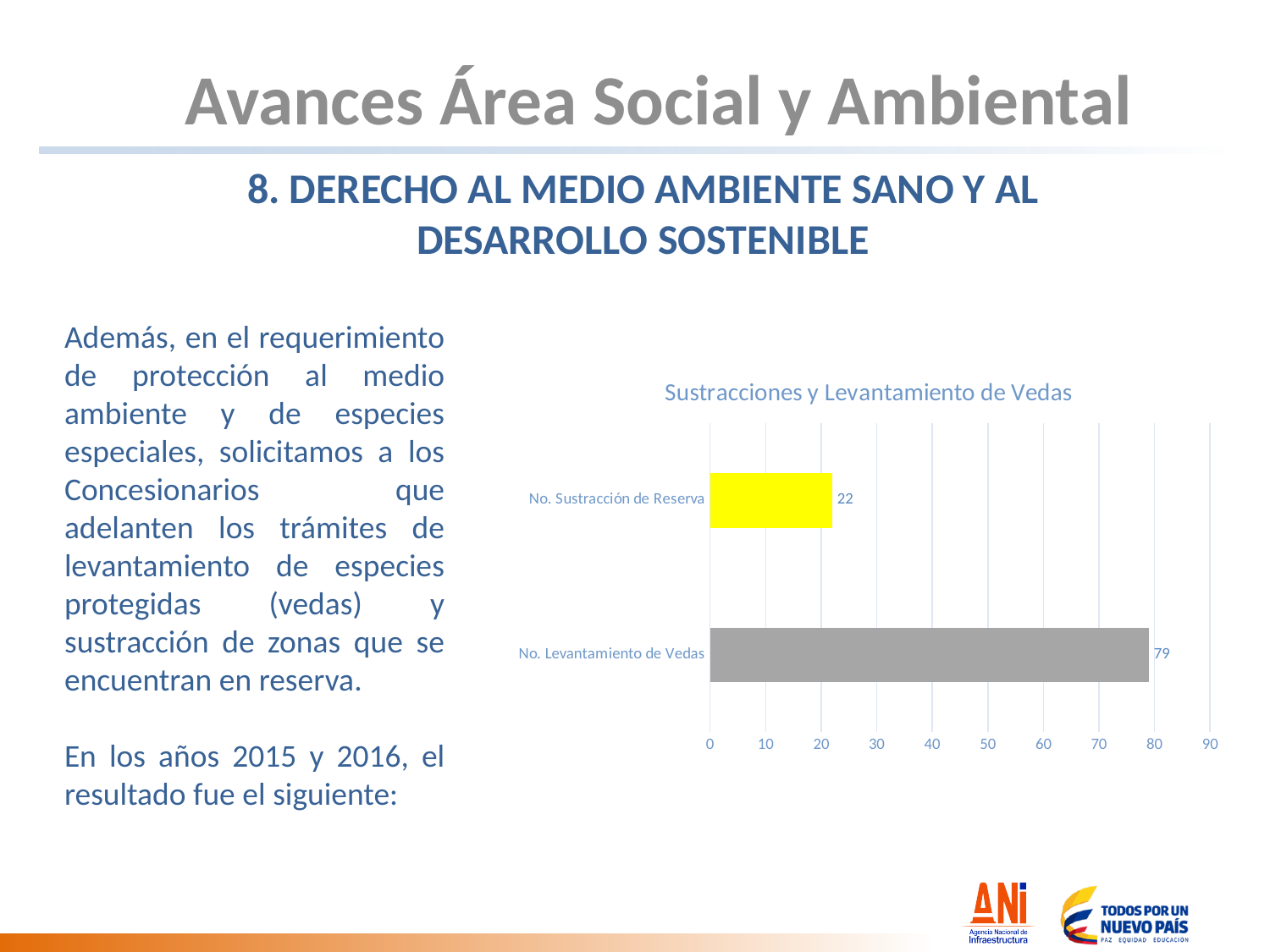
Which is larger, No. Sustracción de Reserva or No. Levantamiento de Vedas? No. Levantamiento de Vedas What colour is the bar for No. Sustracción de Reserva? Yellow How many categories are shown in the chart? 2 What is the difference between No. Levantamiento de Vedas and No. Sustracción de Reserva? 57 Is the value for No. Sustracción de Reserva greater or less than 30? less Which category has the lowest value? No. Sustracción de Reserva What kind of chart is shown on the slide? Bar chart Which category has the highest value? No. Levantamiento de Vedas What is the value for No. Levantamiento de Vedas? 79 What is the value for No. Sustracción de Reserva? 22 Is the value for No. Levantamiento de Vedas greater or less than 70? greater What is the title of the chart? Sustracciones y Levantamiento de Vedas